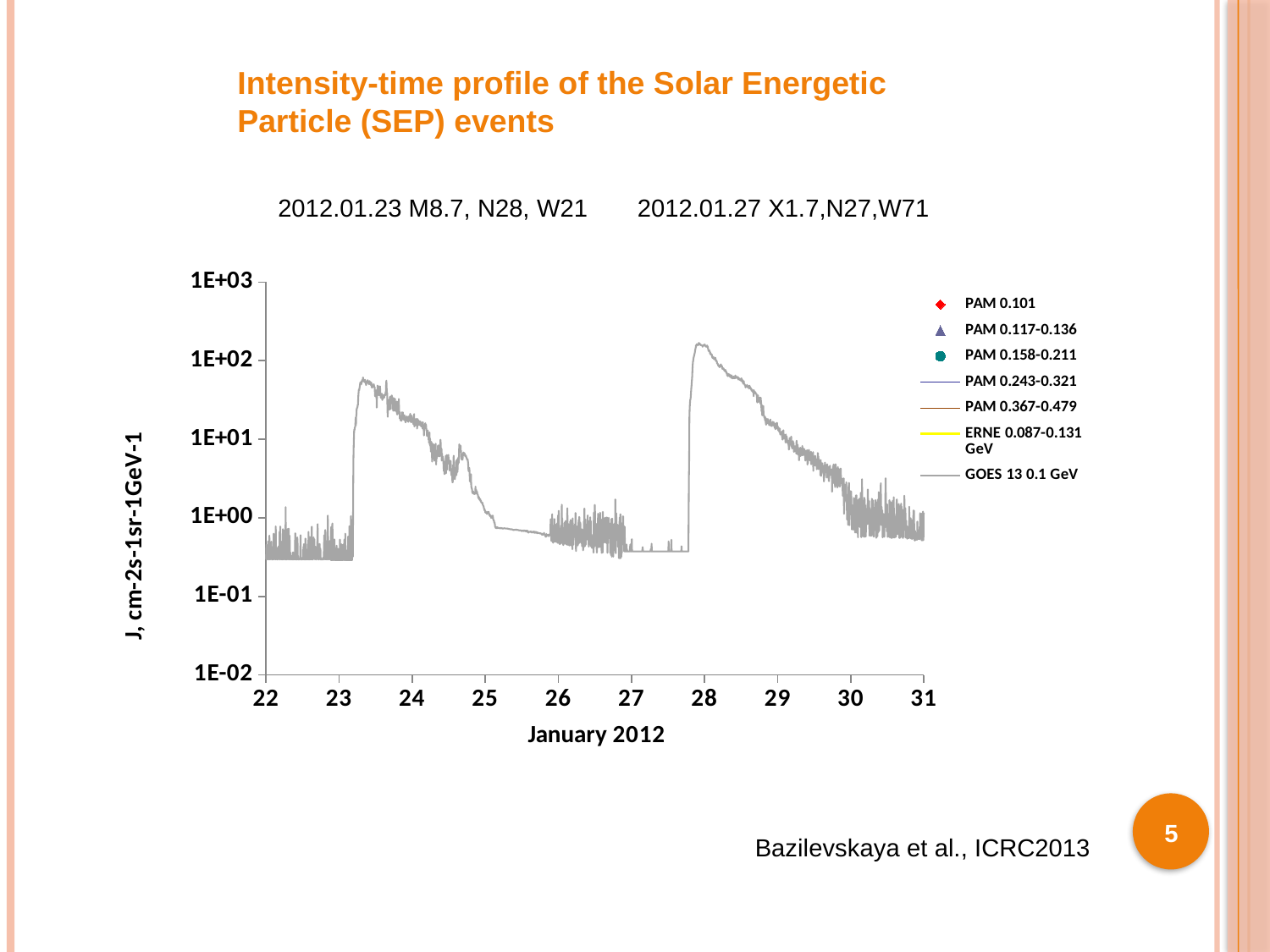
Is the peak intensity reached around 23 January greater or less than 1E+02? less Which peak is higher, the one around 23 January or the one around 28 January? 28 January What is the last entry in the legend? GOES 13 0.1 GeV How many day labels are shown on the x axis? 10 Do the values rise or fall between 28 January and 31 January? fall Is the peak intensity reached around 28 January greater or less than 1E+02? greater Is the peak intensity reached around 23 January greater or less than 1E+01? greater What is the highest tick value shown on the y axis? 1E+03 How many series does the legend list? 7 What is the title of the x axis? January 2012 What kind of chart is shown on the slide? Line chart